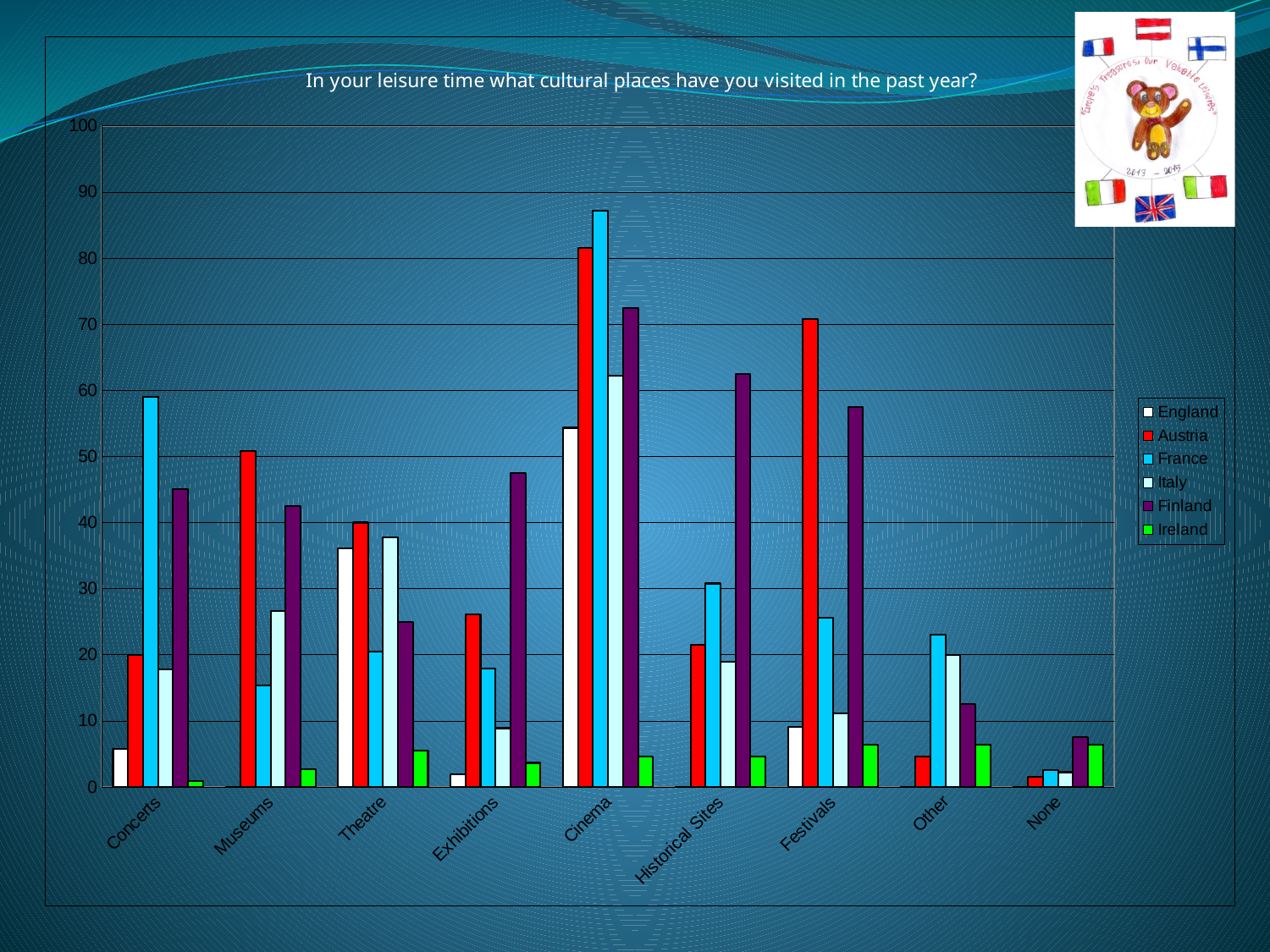
Is the value for Austria at Museums greater or less than 40? greater How many series does the legend list? 6 What kind of chart is shown on the slide? bar chart For which category is the France value highest? Cinema How many categories are shown along the x axis? 9 At Historical Sites, which is larger: the value for Finland or the value for Austria? Finland Is the value for France at Cinema greater or less than 80? greater Is the value for Finland at Concerts greater or less than 40? greater At Cinema, which country has the highest value? France What is the title of the chart? In your leisure time what cultural places have you visited in the past year? At Festivals, which is larger: the value for Austria or the value for France? Austria